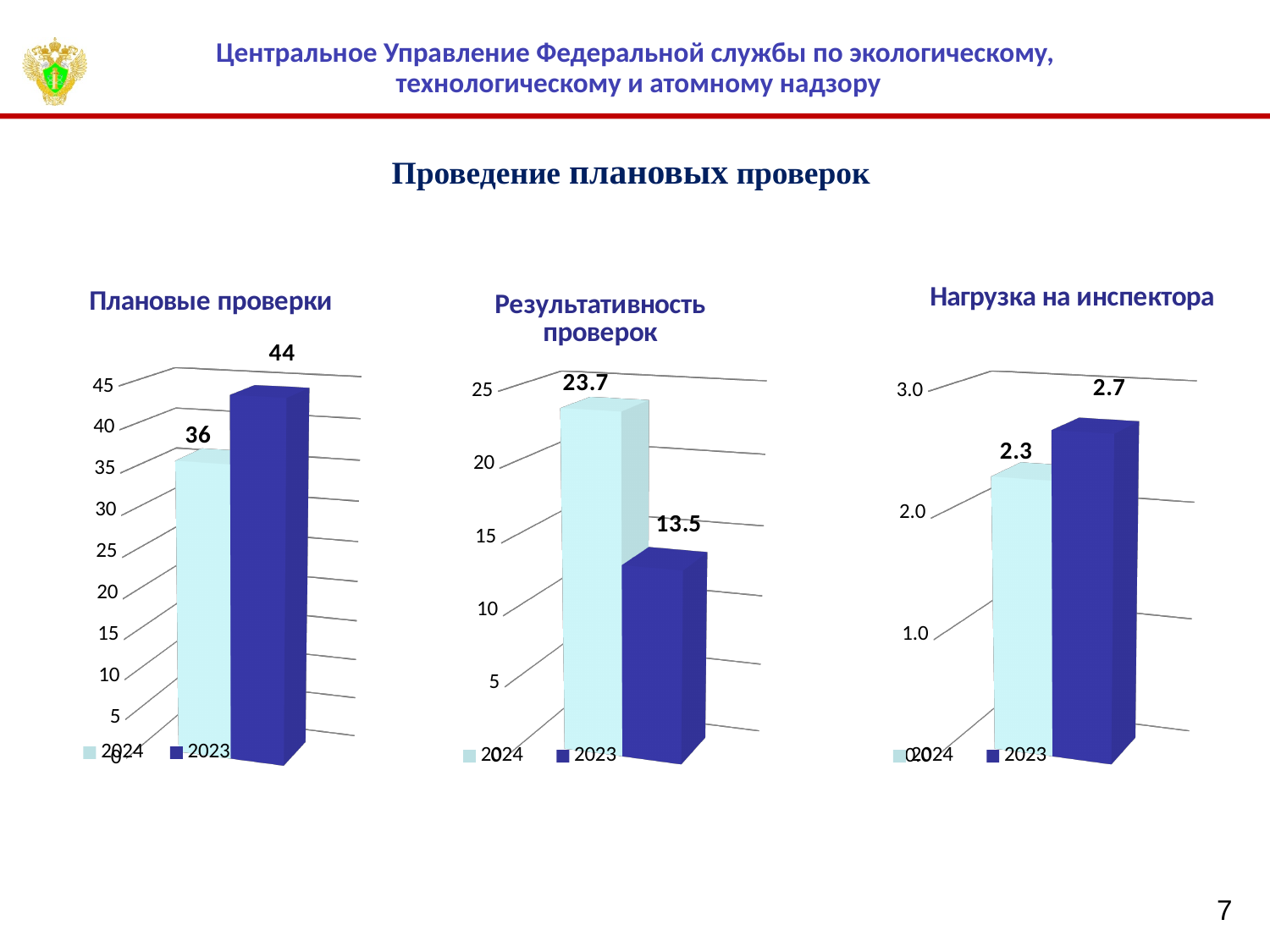
In the 'Результативность проверок' chart, what is the value for 2024? 23.7 In the 'Плановые проверки' chart, what is the value for 2024? 36 In the 'Результативность проверок' chart, what is the value for 2023? 13.5 How many series does the legend of the 'Результативность проверок' chart list? 2 In the 'Результативность проверок' chart, which year has the higher value? 2024 What kind of chart is the 'Нагрузка на инспектора' chart? bar chart In the 'Плановые проверки' chart, what is the difference between the 2023 and 2024 values? 8 In the 'Нагрузка на инспектора' chart, what is the value for 2024? 2.3 In the 'Нагрузка на инспектора' chart, what is the value for 2023? 2.7 In the 'Плановые проверки' chart, what is the value for 2023? 44 In the 'Плановые проверки' chart, is the value for 2023 greater or less than 40? greater In the 'Нагрузка на инспектора' chart, which year has the lower value? 2024